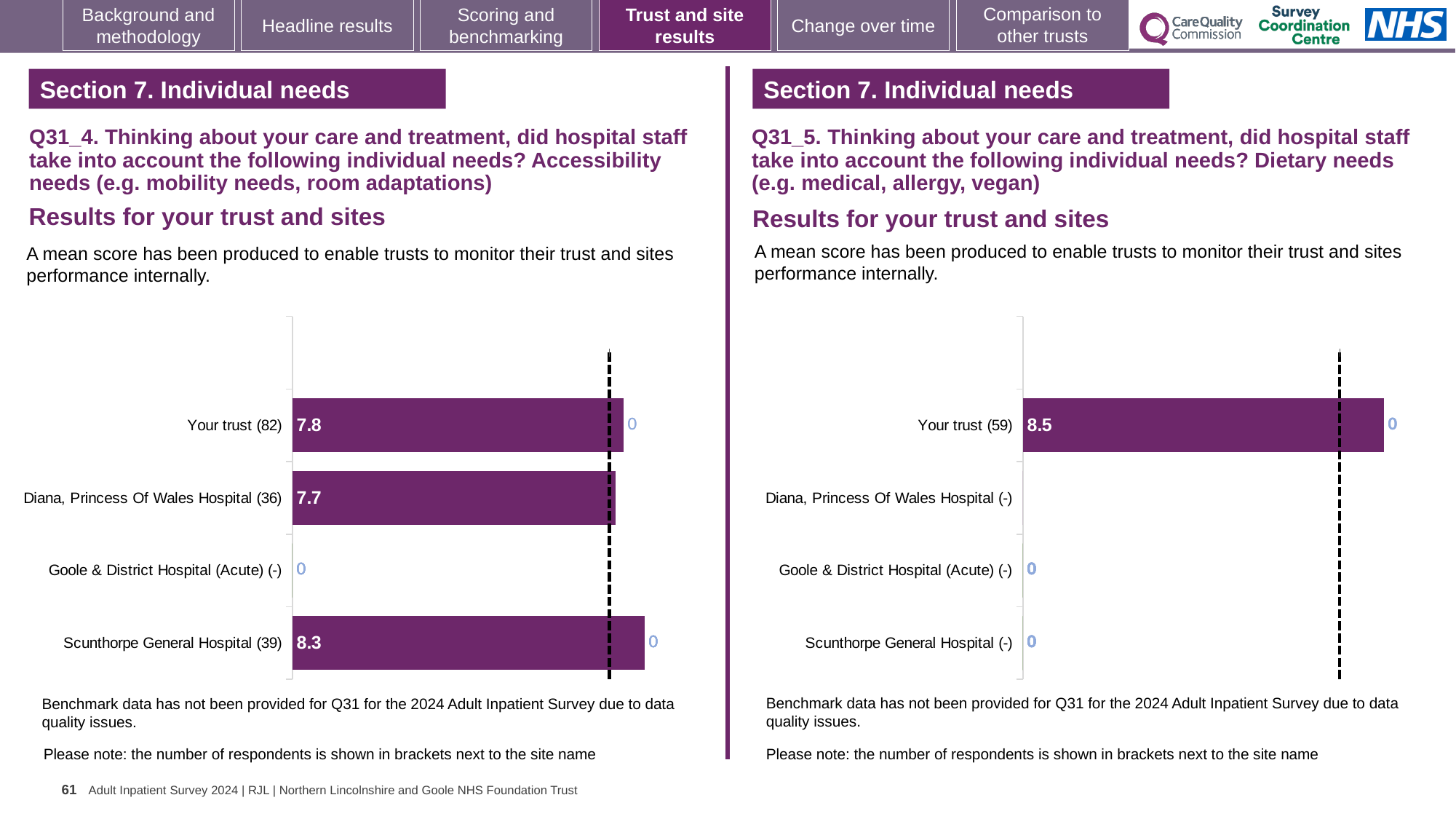
In the left chart (Q31_4, accessibility needs), what is the mean score for Your trust? 7.8 In the left chart (Q31_4, accessibility needs), how many respondents are shown in brackets for Your trust? 82 In the left chart (Q31_4, accessibility needs), what is the difference between the mean scores for Scunthorpe General Hospital and Diana, Princess Of Wales Hospital? 0.6 How many categories are listed on the left chart (Q31_4, accessibility needs)? 4 In the right chart (Q31_5, dietary needs), what is the mean score for Your trust? 8.5 In the right chart (Q31_5, dietary needs), how many respondents are shown in brackets for Your trust? 59 What kind of chart is used on the right (Q31_5, dietary needs)? Bar chart In the left chart (Q31_4, accessibility needs), what is the mean score for Diana, Princess Of Wales Hospital? 7.7 In the left chart (Q31_4, accessibility needs), which site has the highest mean score? Scunthorpe General Hospital In the left chart (Q31_4, accessibility needs), which is larger: the mean score for Your trust or for Scunthorpe General Hospital? Scunthorpe General Hospital In the left chart (Q31_4, accessibility needs), what is the difference between the mean scores for Scunthorpe General Hospital and Your trust? 0.5 In the left chart (Q31_4, accessibility needs), what is the mean score for Scunthorpe General Hospital? 8.3